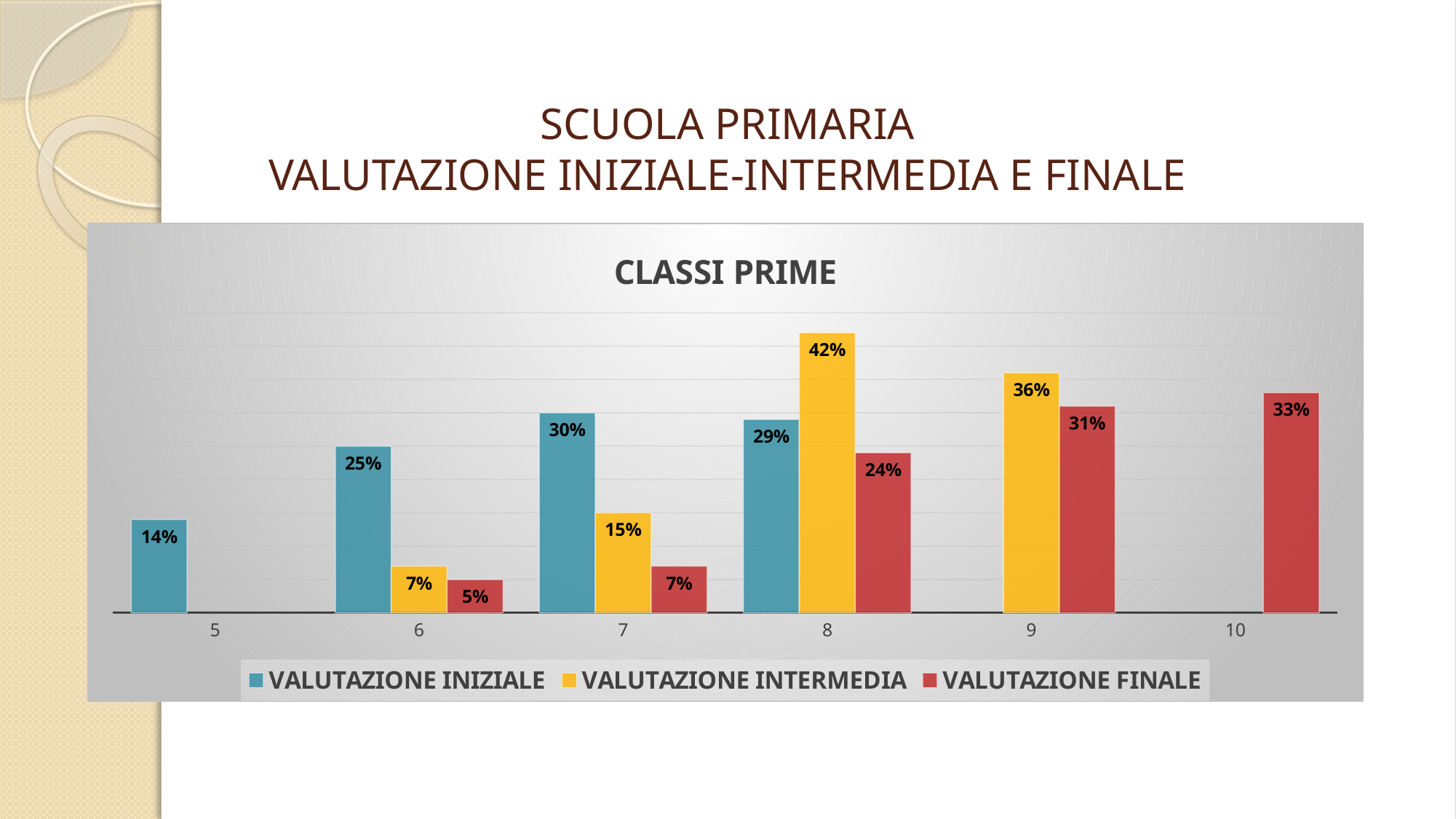
What is the title of the chart? CLASSI PRIME Which category has the lowest VALUTAZIONE FINALE value? 6 Which category has the highest VALUTAZIONE INIZIALE value? 7 What is the difference between the VALUTAZIONE INTERMEDIA and VALUTAZIONE FINALE values for category 8? 18% What is the VALUTAZIONE INTERMEDIA value for category 8? 42% What is the VALUTAZIONE INIZIALE value for category 5? 14% How many series does the legend list? 3 What kind of chart is shown? Bar chart What is the VALUTAZIONE FINALE value for category 10? 33% How many categories are shown on the x axis? 6 What is the VALUTAZIONE FINALE value for category 6? 5% For category 9, which is larger: VALUTAZIONE INTERMEDIA or VALUTAZIONE FINALE? VALUTAZIONE INTERMEDIA